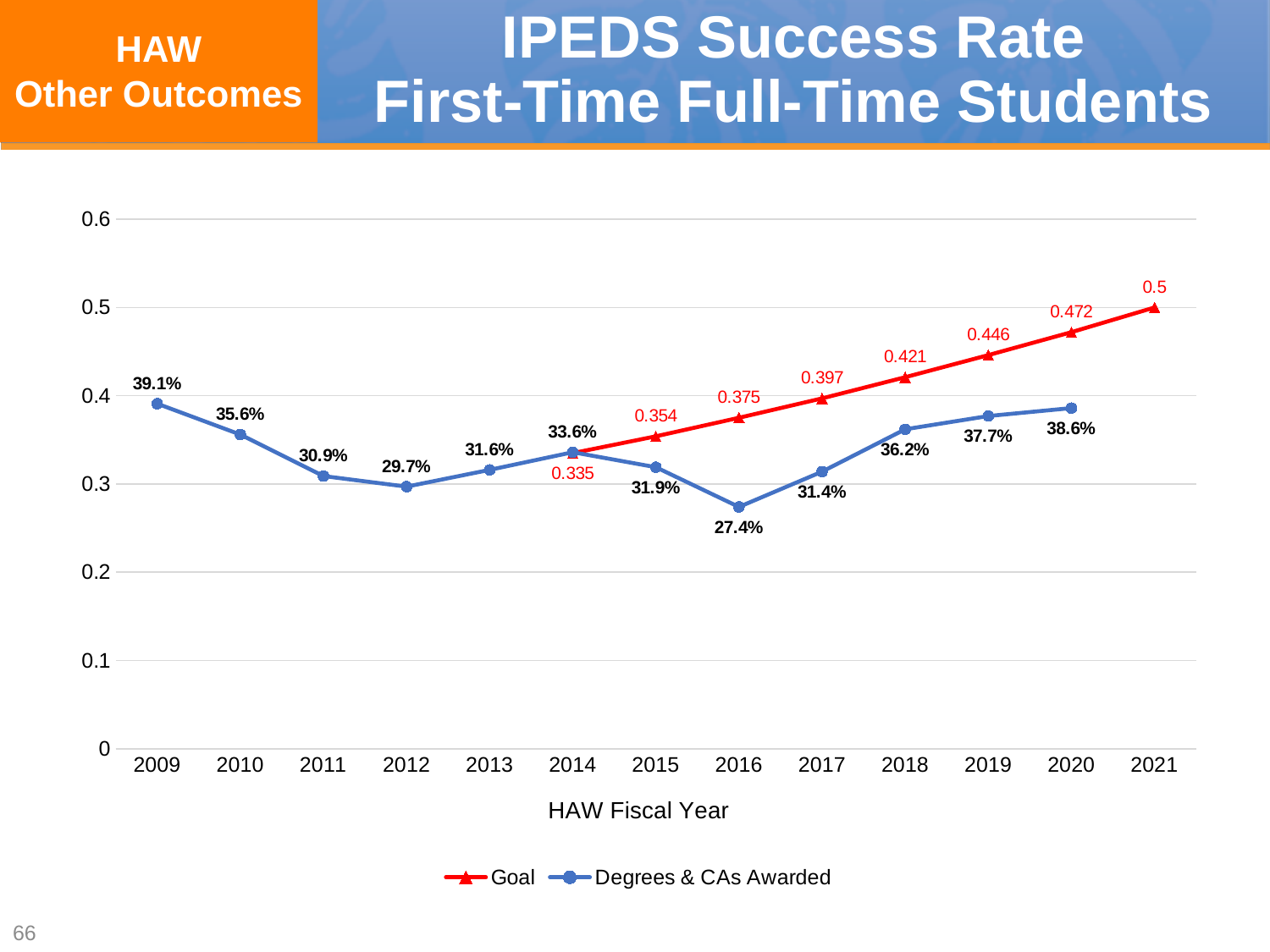
How many years are shown on the x axis? 13 What is the value for Degrees & CAs Awarded in 2016? 27.4% In which year is the Degrees & CAs Awarded value highest? 2009 What is the difference between the Degrees & CAs Awarded values for 2020 and 2019? 0.9% What is the value for Degrees & CAs Awarded in 2009? 39.1% What kind of chart is shown on the slide? Line chart In which year is the Degrees & CAs Awarded value lowest? 2016 Is the Degrees & CAs Awarded value for 2012 greater or less than 0.3? less What is the Goal value for 2018? 0.421 How many series does the legend list? 2 Which is larger in 2020, the Goal value or the Degrees & CAs Awarded value? Goal What is the Goal value for 2021? 0.5